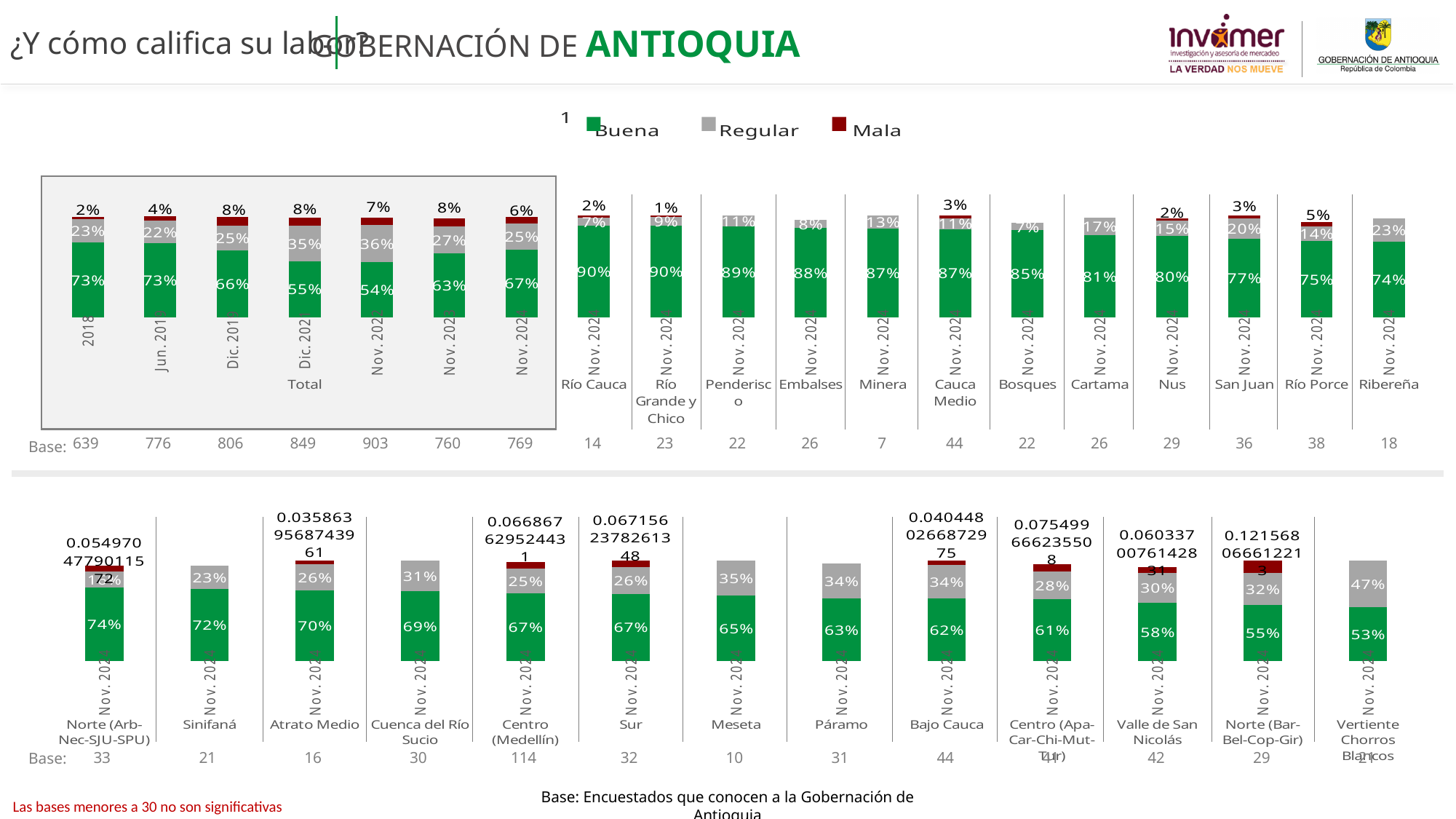
In the top-right subregion chart, what is the Buena percentage for Cartama? 81% How many series does the legend list? 3 How many time periods are shown in the Total chart? 7 In the bottom chart, which has the larger Buena percentage, Meseta or Bajo Cauca? Meseta In the bottom chart, what is the Regular percentage for Cuenca del Río Sucio? 31% In the bottom chart, which subregion has the lowest Buena percentage? Vertiente Chorros Blancos What kind of chart is used on this slide? stacked bar chart